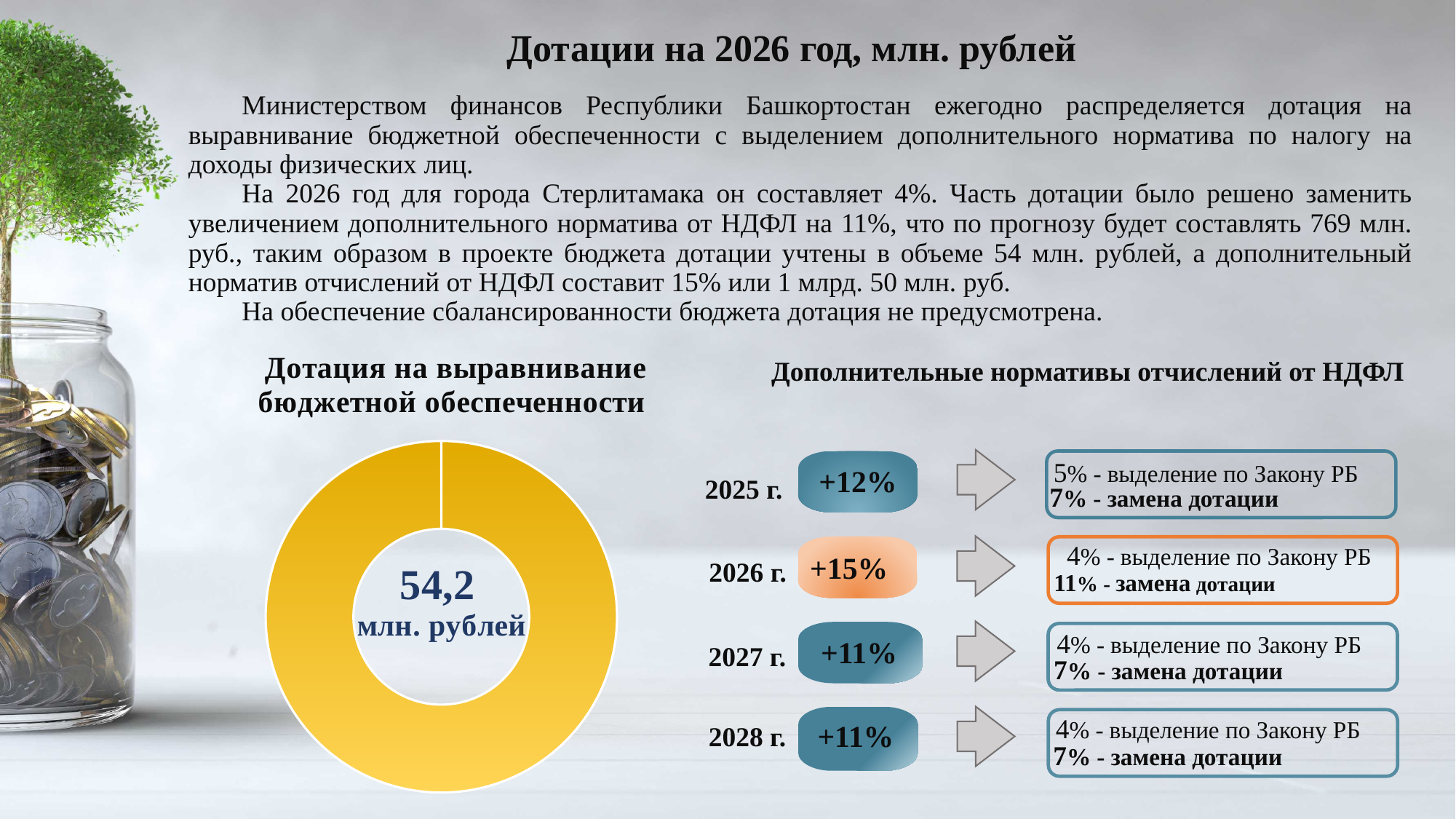
In the doughnut chart, what unit is given for the value 54,2? млн. рублей What value is printed in the centre of the doughnut chart? 54,2 млн. рублей What is the title of the doughnut chart on the slide? Дотация на выравнивание бюджетной обеспеченности What kind of chart is shown under the title "Дотация на выравнивание бюджетной обеспеченности"? Doughnut chart What colour is the ring of the doughnut chart? Yellow How many slices does the doughnut chart show? 1